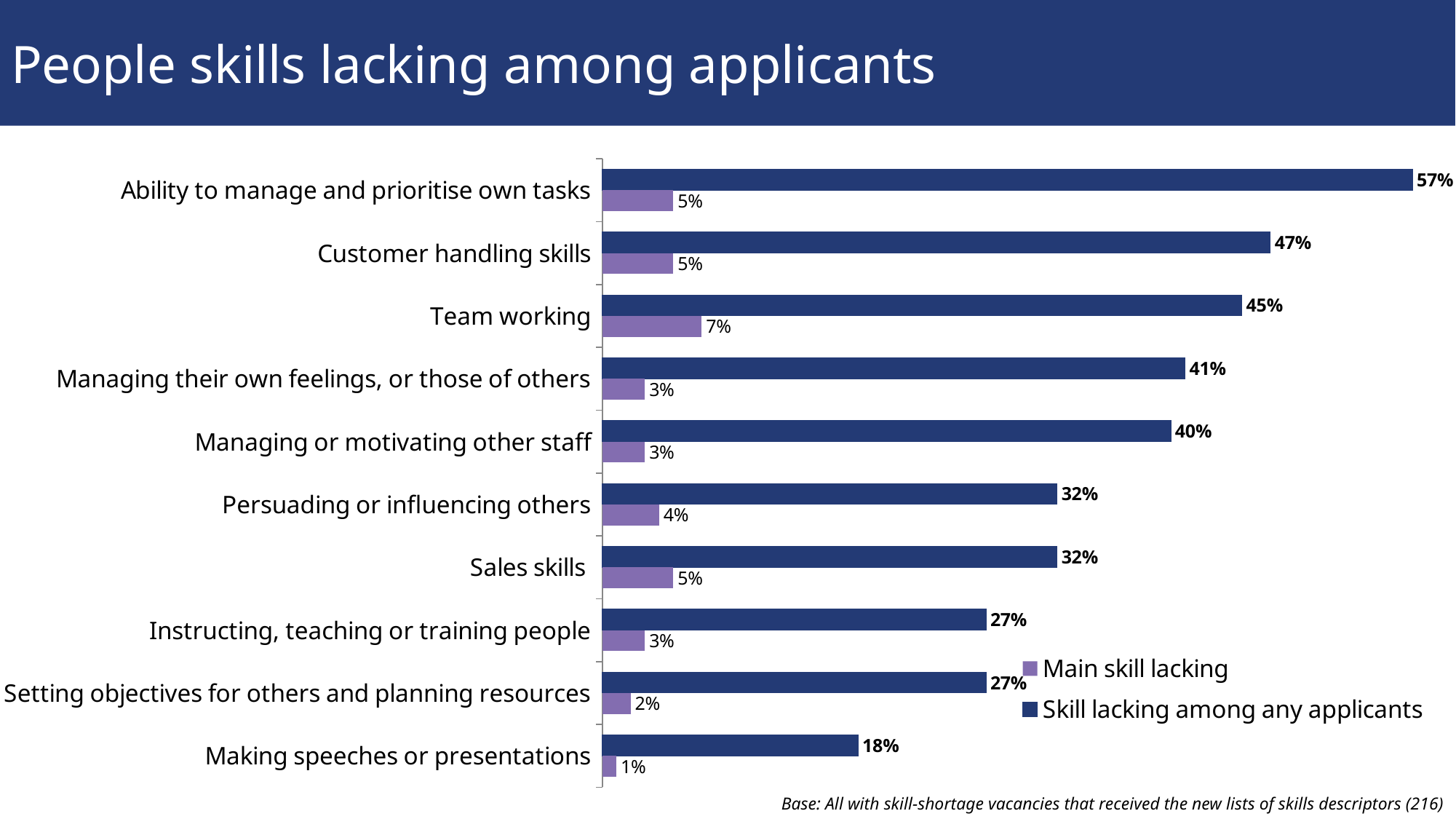
What is the value for 'Main skill lacking' for Team working? 7% Which is larger for 'Skill lacking among any applicants': Managing or motivating other staff or Persuading or influencing others? Managing or motivating other staff How many series does the legend list? 2 What is the difference between the 'Skill lacking among any applicants' values for Customer handling skills and Making speeches or presentations? 29% How many categories are shown on the chart? 10 Which category has the highest value for 'Skill lacking among any applicants'? Ability to manage and prioritise own tasks Which series is shown in purple? Main skill lacking What is the value for 'Main skill lacking' for Making speeches or presentations? 1% What is the value for 'Skill lacking among any applicants' for Team working? 45% What kind of chart is shown on the slide? Bar chart What is the difference between the two series values for Sales skills? 27% Which category has the lowest value for 'Main skill lacking'? Making speeches or presentations